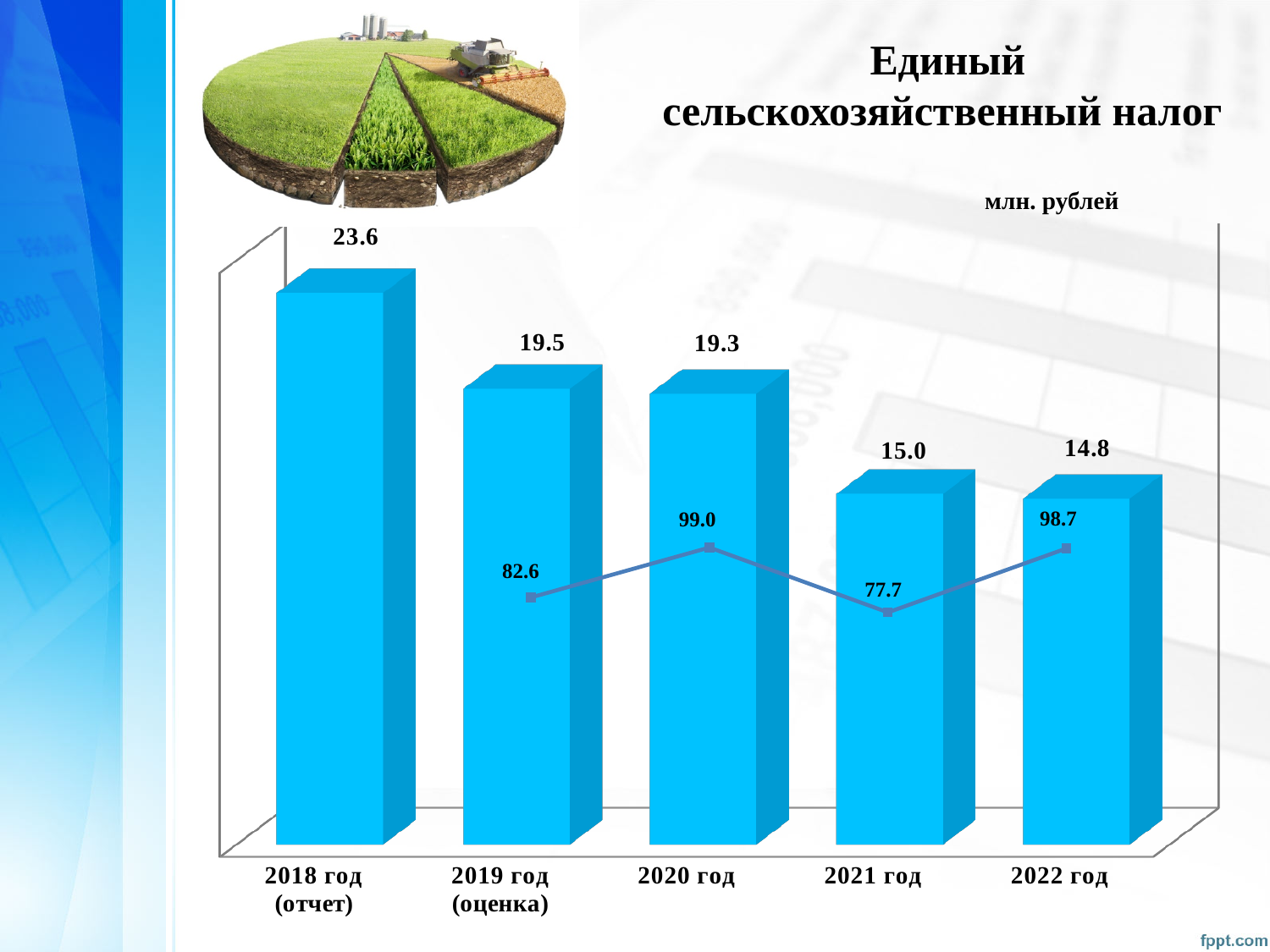
What is the bar value for 2021 год? 15.0 What is the bar value for 2018 год (отчет)? 23.6 Do the bar values rise or fall from 2018 to 2022? fall What is the bar value for 2022 год? 14.8 What is the difference between the bar values for 2018 год (отчет) and 2019 год (оценка)? 4.1 What is the line value shown for 2020 год? 99.0 How many years are shown on the x axis? 5 Which is larger, the line value for 2019 год (оценка) or for 2022 год? 2022 год What is the line value shown for 2021 год? 77.7 What is the title of the chart? Единый сельскохозяйственный налог Which year has the lowest bar value? 2022 год Which year has the highest bar value? 2018 год (отчет)